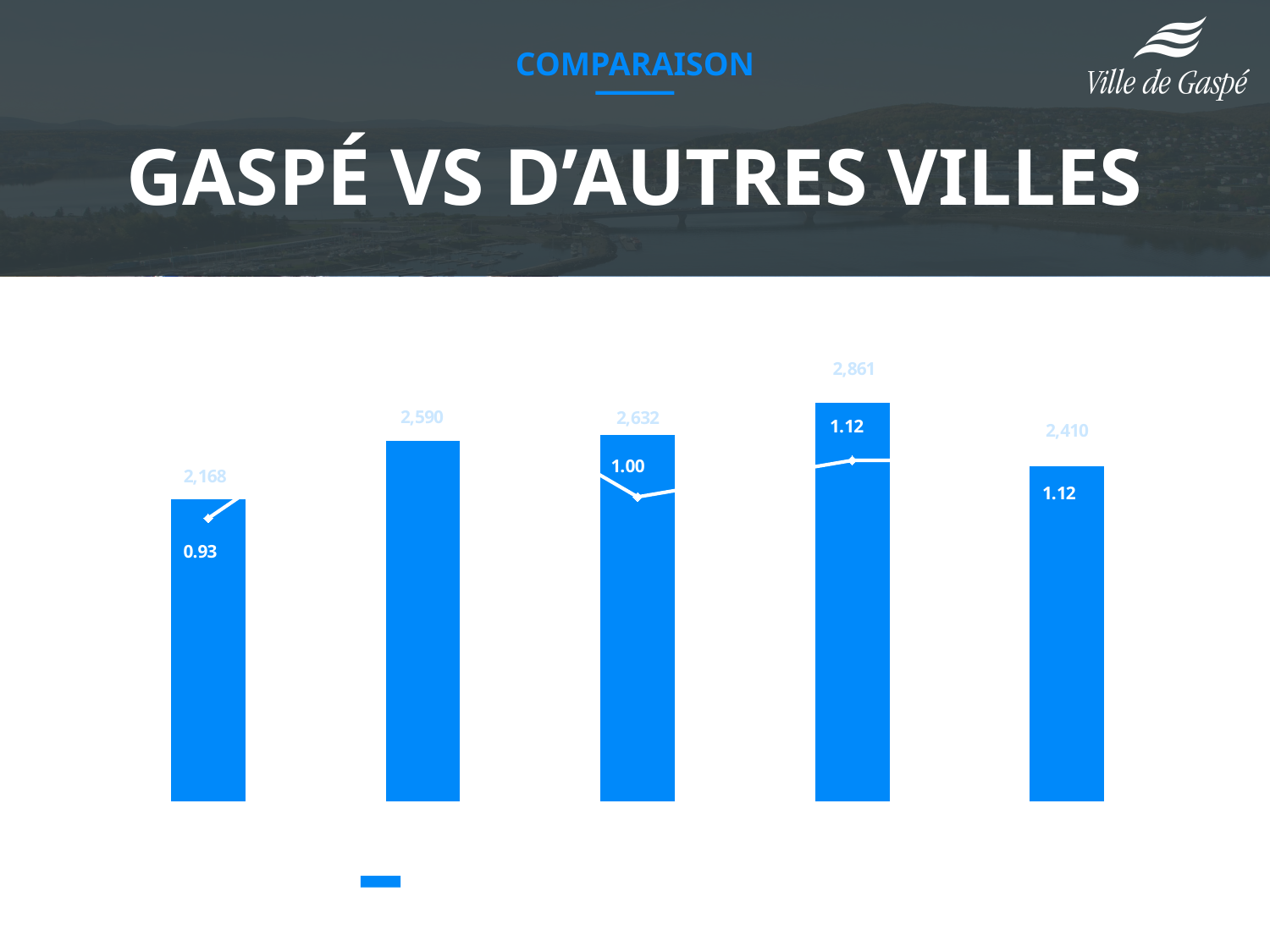
How many bars are plotted in the chart? 5 Which bar has the lowest value, counting from the left? The first bar (2,168) Which is larger, the value of the second bar or the value of the fifth bar? The second bar (2,590) What is the data label on the first bar from the left? 2,168 What kind of chart is shown on the slide? A bar chart with a line series overlaid What is the line-series value shown on the first bar from the left? 0.93 What is the data label on the fourth bar from the left? 2,861 What is the difference between the highest bar value (2,861) and the lowest bar value (2,168)? 693 What is the line-series value shown on the fourth bar from the left? 1.12 What is the data label on the rightmost bar? 2,410 Which bar has the highest value, counting from the left? The fourth bar (2,861) What is the difference between the second bar (2,590) and the third bar (2,632)? 42